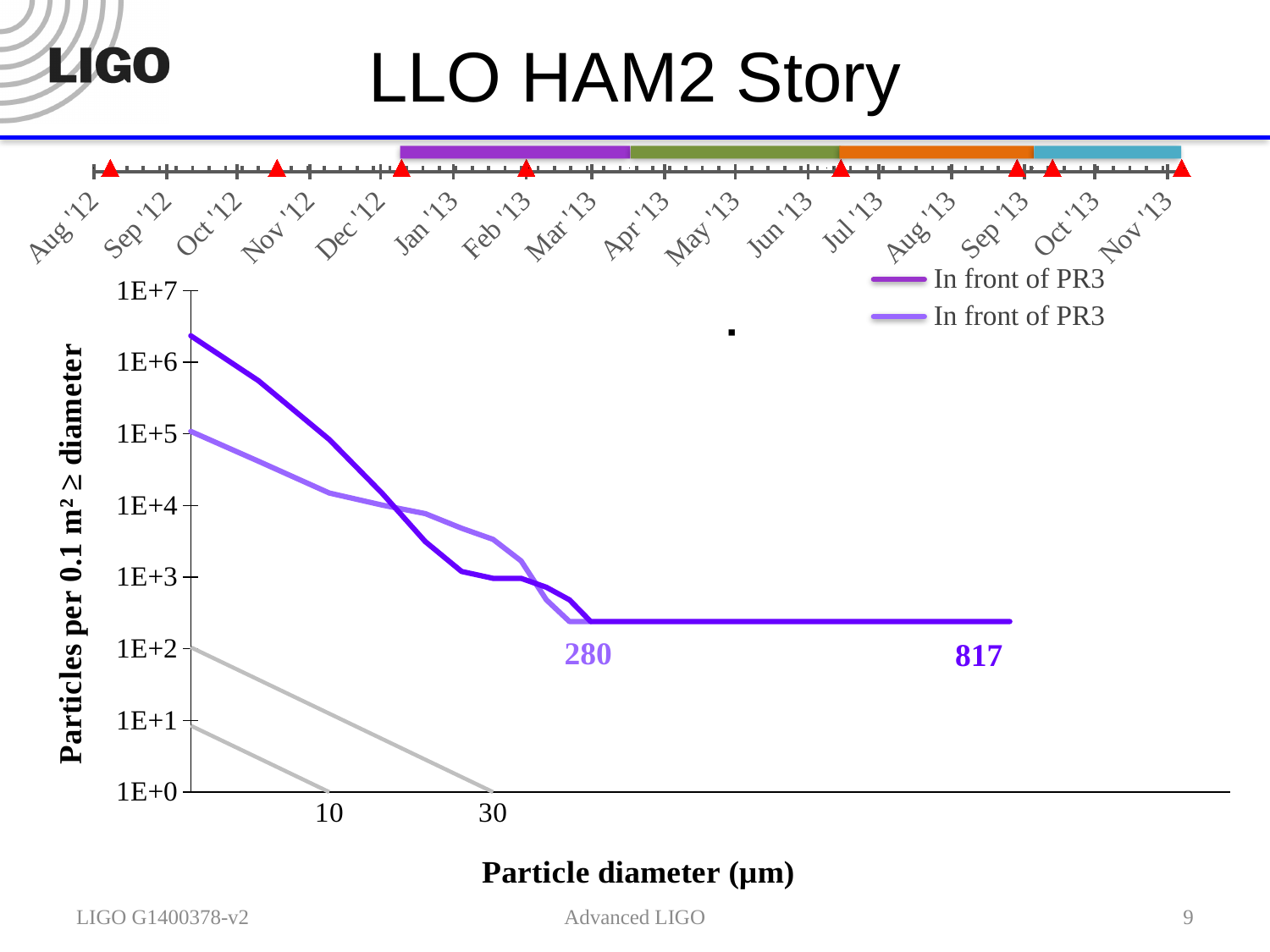
What value is printed as the dark purple data label on the chart? 817 How many series does the chart legend list? 2 What is the difference between the two printed data labels, 817 and 280? 537 Which printed data label is larger, 280 or 817? 817 At the smallest particle diameter on the left of the chart, is the dark purple line greater or less than 1E+6? greater What kind of chart is shown on the slide? line chart At a particle diameter of 30 µm, which line is higher, the dark purple or the light purple? light purple Do the plotted particle counts rise or fall as particle diameter increases along the x axis? fall What is the label on the y axis of the chart? Particles per 0.1 m² ≥ diameter At a particle diameter of 30 µm, is the dark purple line greater or less than 1E+4? less What value is printed as the light purple data label on the chart? 280 What is the label on the x axis of the chart? Particle diameter (µm)